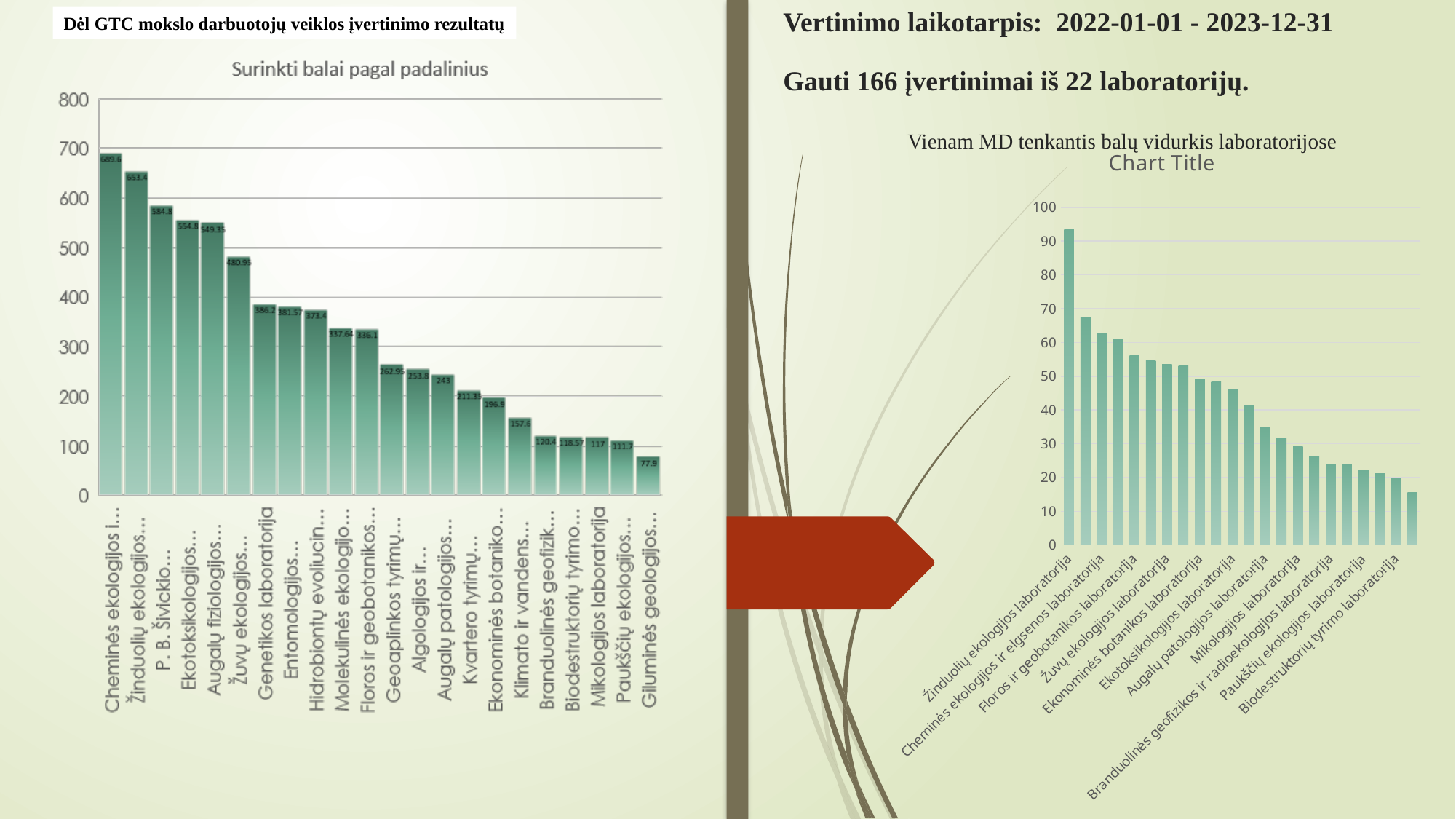
How many bars does the left chart 'Surinkti balai pagal padalinius' show? 22 In the left chart 'Surinkti balai pagal padalinius', what is the value of the highest bar? 689.6 In the right chart labelled 'Chart Title', is the value for Žinduolių ekologijos laboratorija greater or less than 80? greater In the left chart 'Surinkti balai pagal padalinius', what is the value for Mikologijos laboratorija? 117 In the left chart 'Surinkti balai pagal padalinius', what is the value for Genetikos laboratorija? 386.2 What type of chart is the left chart titled 'Surinkti balai pagal padalinius'? bar chart In the left chart 'Surinkti balai pagal padalinius', what is the value of the lowest bar? 77.9 What type of chart is the right chart labelled 'Chart Title'? bar chart In the left chart 'Surinkti balai pagal padalinius', what is the difference between Genetikos laboratorija and Mikologijos laboratorija? 269.2 In the right chart labelled 'Chart Title', do the values rise or fall from left to right along the x axis? fall In the right chart labelled 'Chart Title', is the value for Mikologijos laboratorija greater or less than 40? less In the left chart 'Surinkti balai pagal padalinius', which is larger: Genetikos laboratorija or Mikologijos laboratorija? Genetikos laboratorija